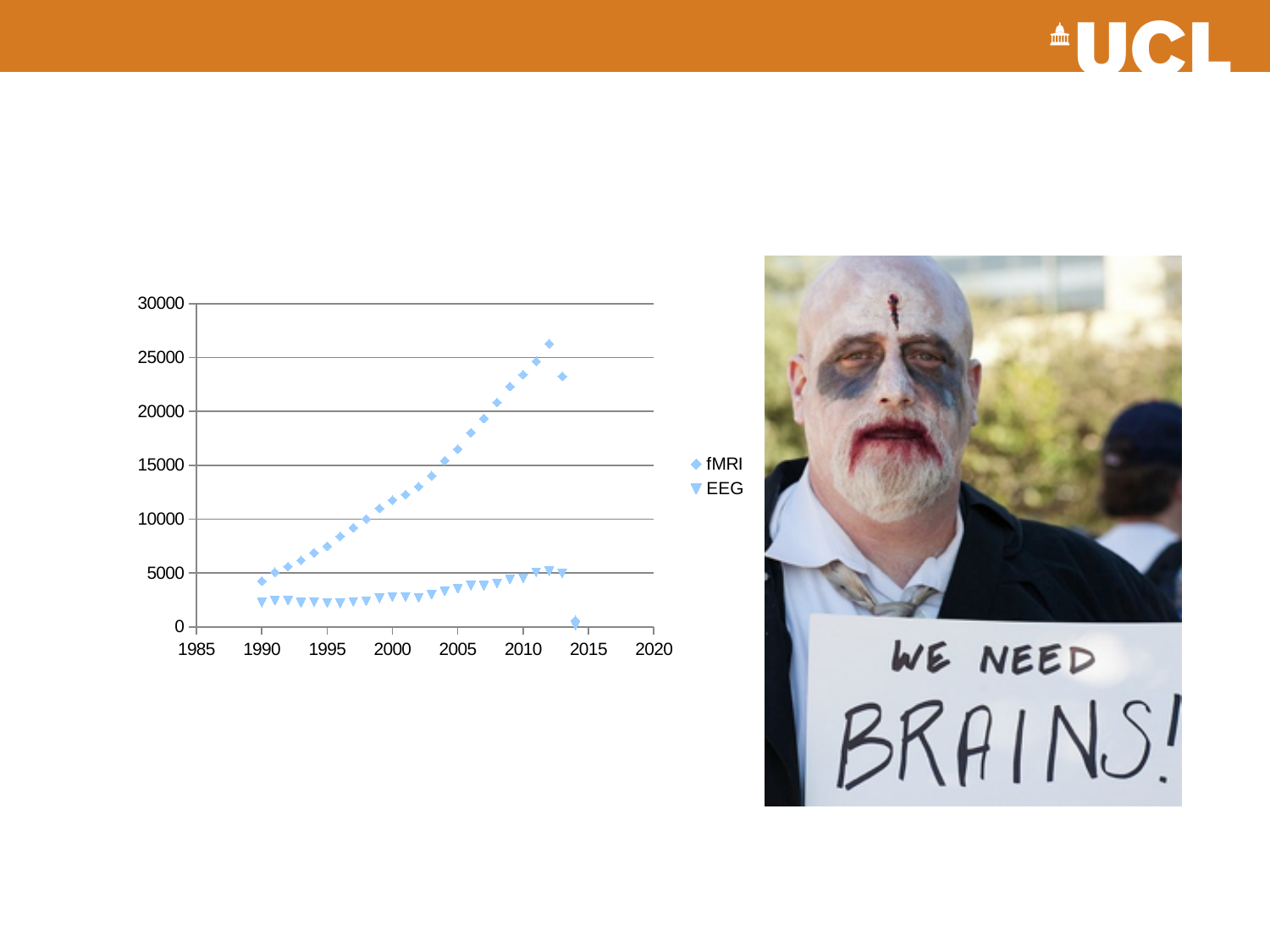
Is the EEG value for 2000 greater or less than 5000? less In 2010, which series has the larger value, fMRI or EEG? fMRI What kind of chart is shown on the slide? scatter chart What are the two series named in the chart legend? fMRI and EEG How many series does the chart legend list? 2 Do the fMRI values rise or fall between 1990 and 2012? rise What marker shape is used for the EEG series? triangles Is the EEG value for 1995 greater or less than 5000? less Is the fMRI value for 2012 greater or less than 25000? greater Which series reaches the highest value on the chart? fMRI